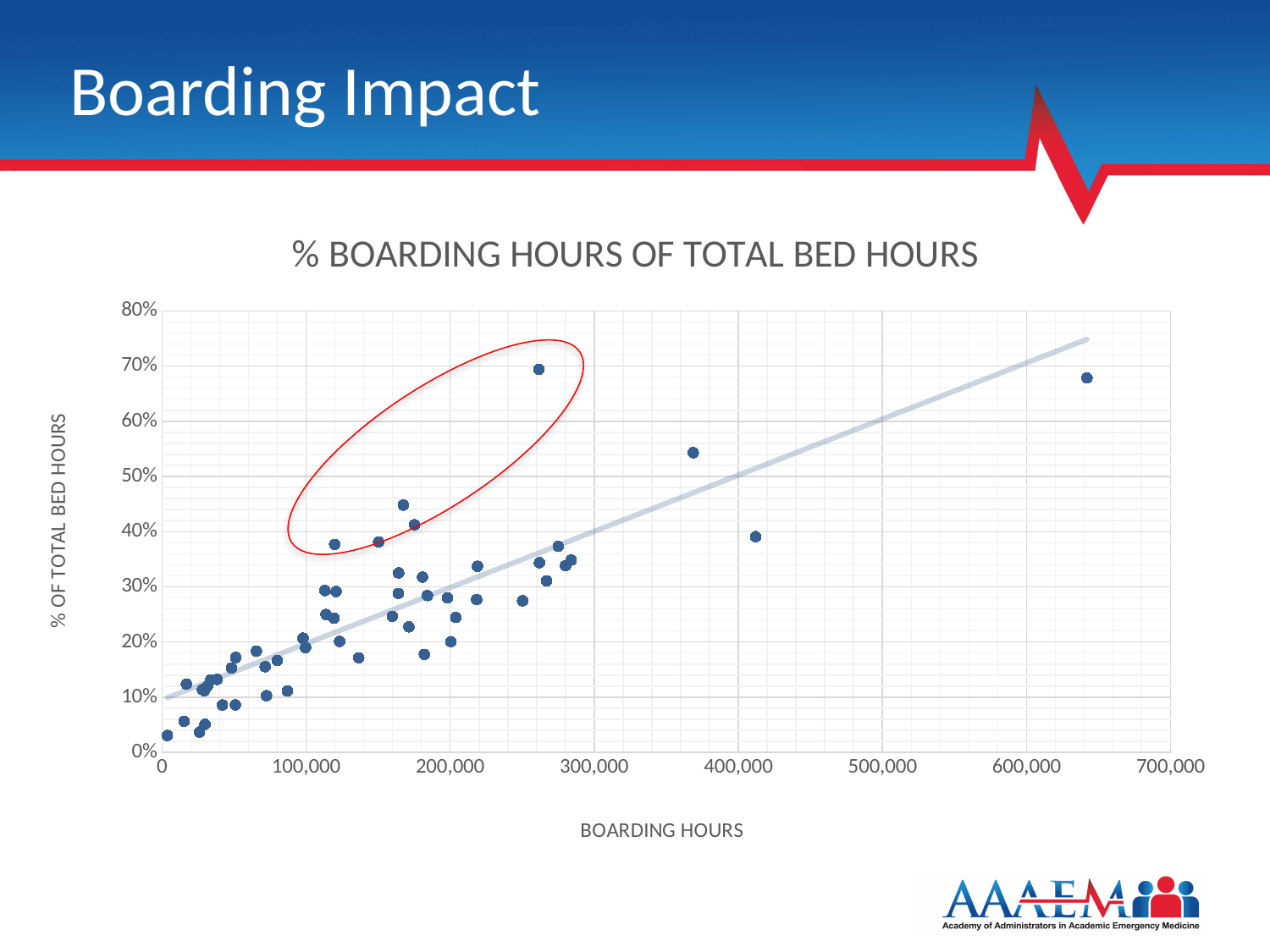
Is the value for the point at roughly 370,000 boarding hours greater or less than 50%? greater What is the label of the horizontal axis? BOARDING HOURS Is the value for the point at roughly 410,000 boarding hours greater or less than 50%? less What is the title of the chart? % BOARDING HOURS OF TOTAL BED HOURS Is the value for the point with the highest boarding hours (around 640,000) greater or less than 60%? greater Do the plotted values generally rise or fall as boarding hours increase along the x axis? rise What is the highest tick value shown on the vertical axis? 80% What kind of chart is shown on the slide? scatter chart What is the highest tick value shown on the horizontal axis? 700,000